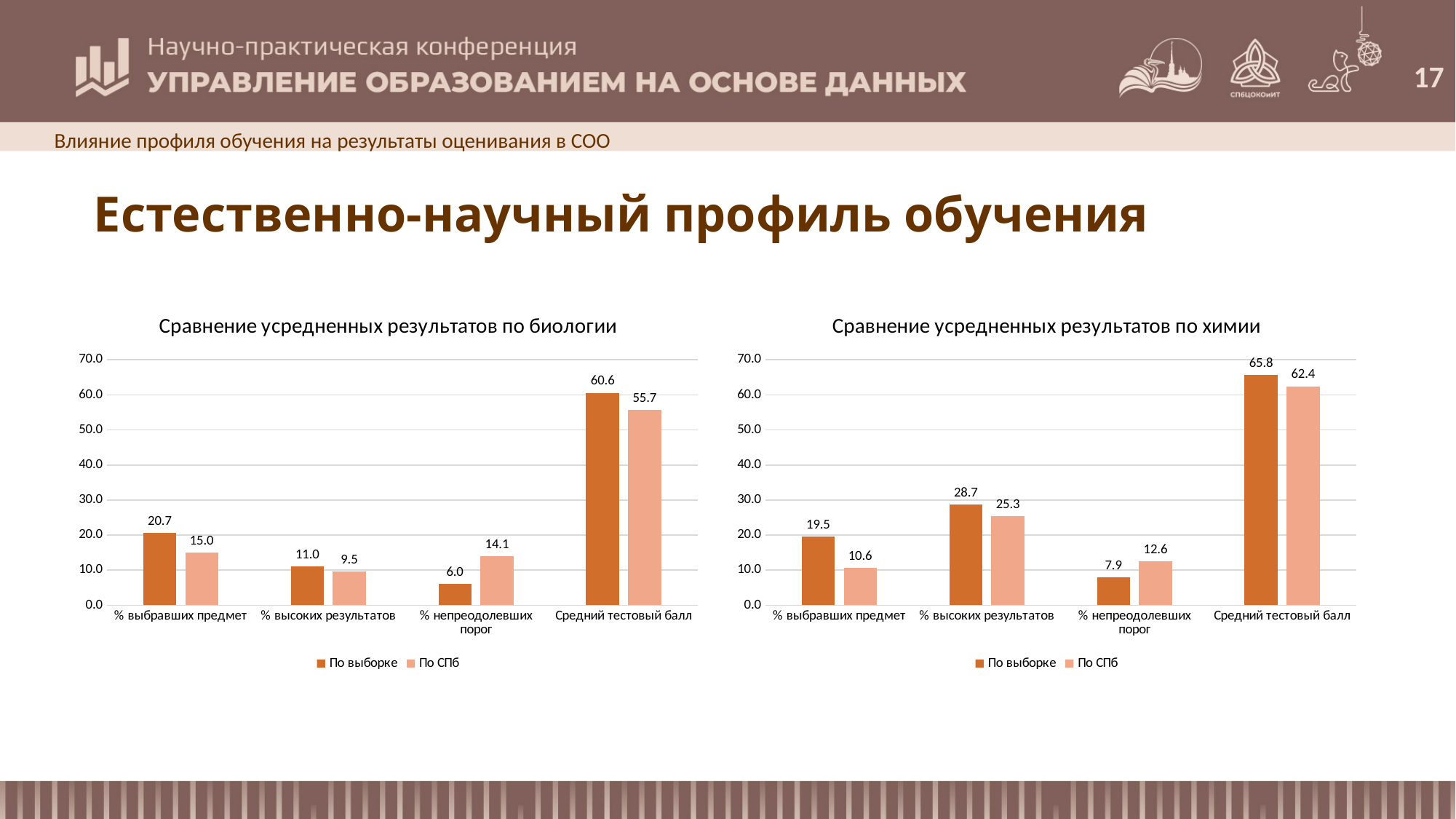
What type of chart is 'Сравнение усредненных результатов по химии'? Bar chart In the chart 'Сравнение усредненных результатов по химии', what is the value of 'По СПб' for 'Средний тестовый балл'? 62.4 In the chart 'Сравнение усредненных результатов по биологии', what is the difference between 'По выборке' and 'По СПб' for 'Средний тестовый балл'? 4.9 In the chart 'Сравнение усредненных результатов по биологии', which category has the lowest 'По выборке' value? % непреодолевших порог In the chart 'Сравнение усредненных результатов по биологии', what is the value of 'По выборке' for '% выбравших предмет'? 20.7 In the chart 'Сравнение усредненных результатов по биологии', is the 'По СПб' value for 'Средний тестовый балл' greater or less than 50.0? greater How many series does the legend of the chart 'Сравнение усредненных результатов по биологии' list? 2 In the chart 'Сравнение усредненных результатов по химии', what is the difference between 'По выборке' and 'По СПб' for '% высоких результатов'? 3.4 In the chart 'Сравнение усредненных результатов по химии', which is larger for '% непреодолевших порог': 'По выборке' or 'По СПб'? По СПб How many categories are shown on the x axis of the chart 'Сравнение усредненных результатов по химии'? 4 In the chart 'Сравнение усредненных результатов по химии', which category has the highest 'По выборке' value? Средний тестовый балл In the chart 'Сравнение усредненных результатов по биологии', what is the value of 'По СПб' for '% непреодолевших порог'? 14.1